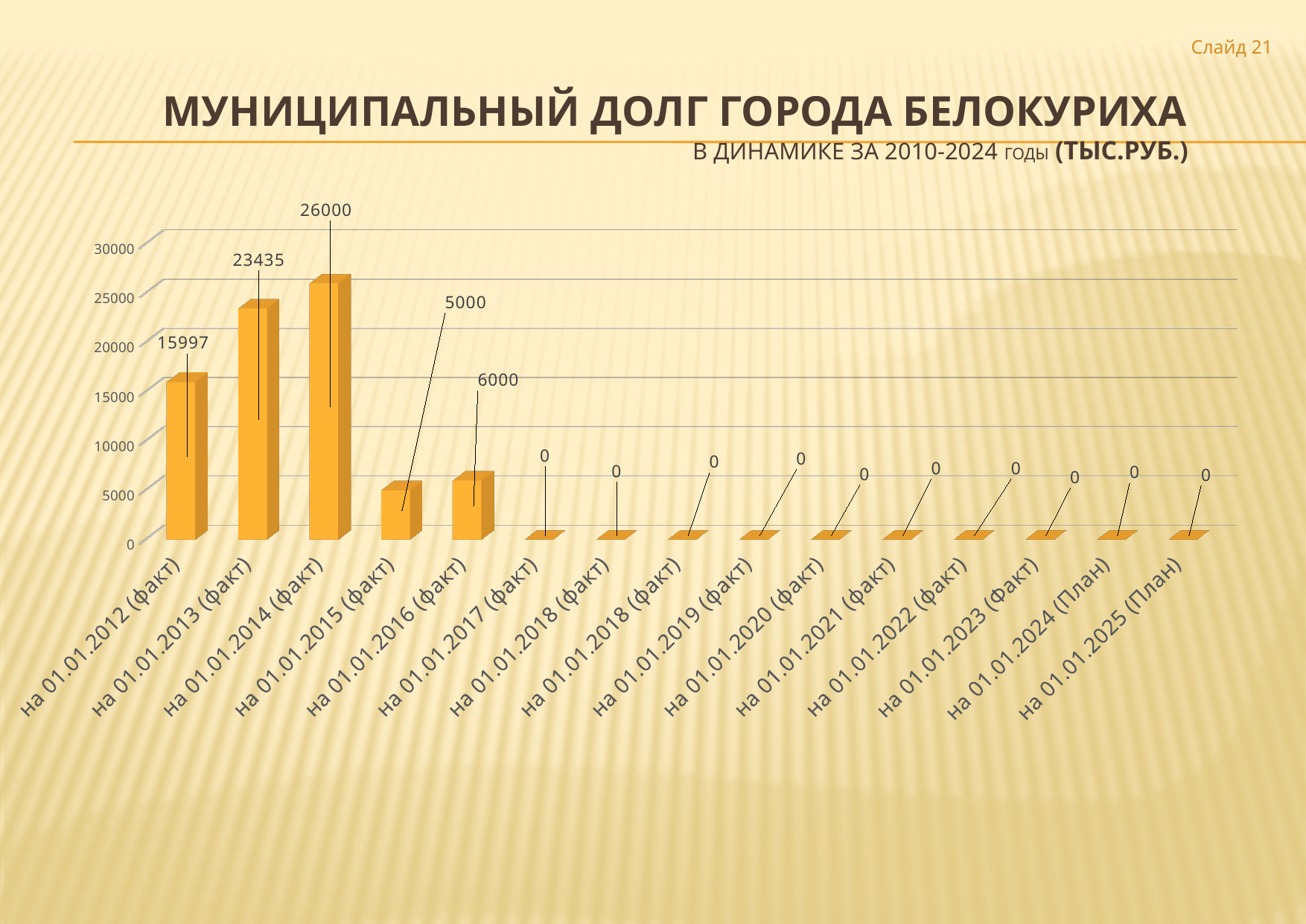
What is the value shown for на 01.01.2016 (факт)? 6000 Which is larger, the value for на 01.01.2015 (факт) or на 01.01.2016 (факт)? на 01.01.2016 (факт) What is the value shown for на 01.01.2024 (План)? 0 What is the difference between the values for на 01.01.2014 (факт) and на 01.01.2013 (факт)? 2565 Do the values rise or fall from на 01.01.2014 (факт) to на 01.01.2017 (факт)? fall What is the difference between the values for на 01.01.2013 (факт) and на 01.01.2012 (факт)? 7438 What is the value shown for на 01.01.2013 (факт)? 23435 What kind of chart is shown on the slide? bar chart Which category has the highest value on the chart? на 01.01.2014 (факт) How many categories are shown on the x axis of the chart? 15 What is the municipal debt value for на 01.01.2012 (факт)? 15997 What is the value shown for на 01.01.2015 (факт)? 5000